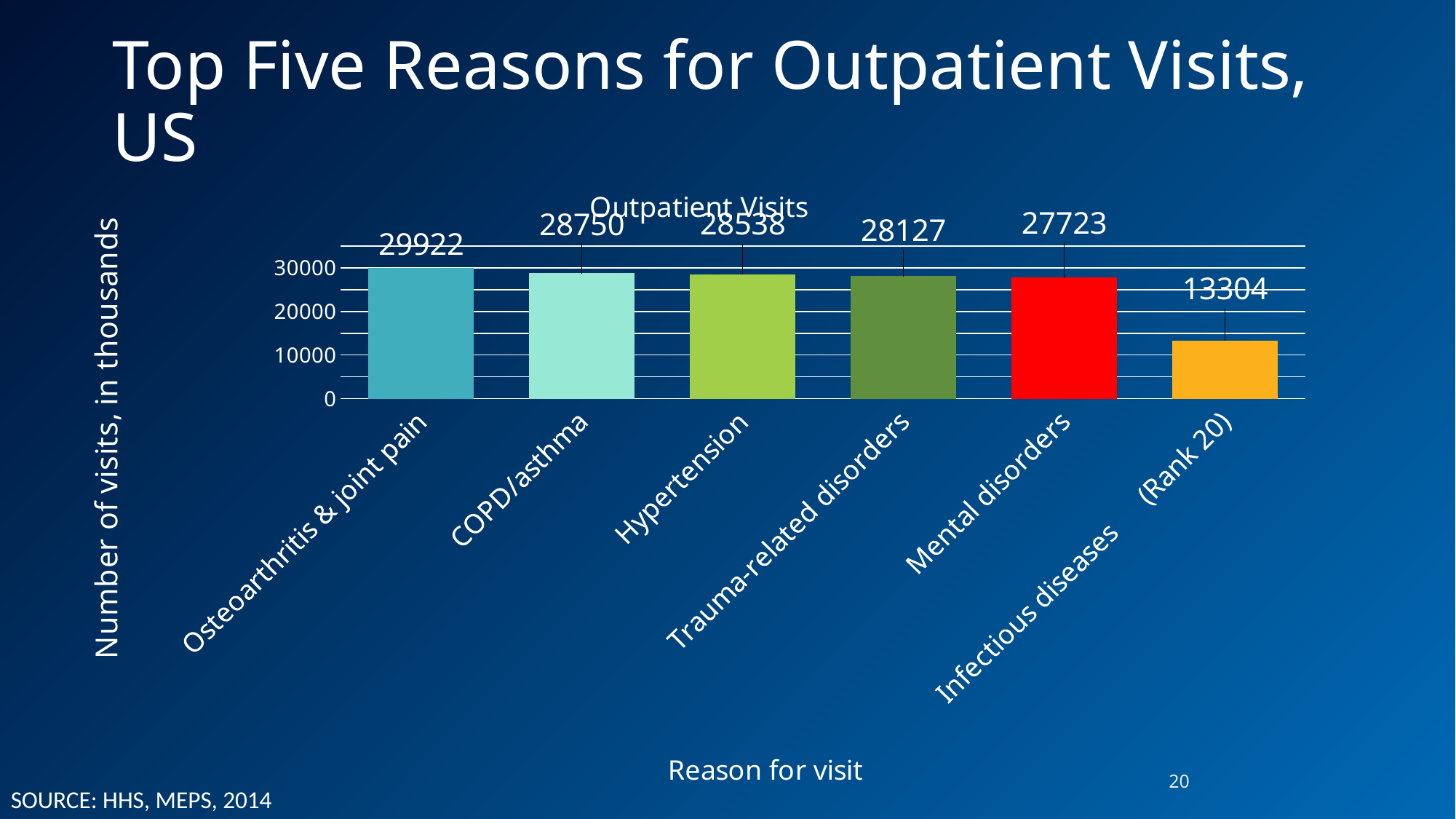
What is the value for Infectious diseases (Rank 20)? 13304 Which reason for visit has the lowest number of visits? Infectious diseases (Rank 20) Which is larger, the value for Trauma-related disorders or the value for Infectious diseases (Rank 20)? Trauma-related disorders Is the value for Mental disorders greater or less than 20000? greater What is the title of the chart? Outpatient Visits How many categories are shown on the x axis? 6 What is the difference between the values for Osteoarthritis & joint pain and Infectious diseases (Rank 20)? 16618 What is the difference between the values for COPD/asthma and Mental disorders? 1027 Which reason for visit has the highest number of visits? Osteoarthritis & joint pain What is the value for Osteoarthritis & joint pain? 29922 What is the value for Hypertension? 28538 What kind of chart is shown on the slide? bar chart